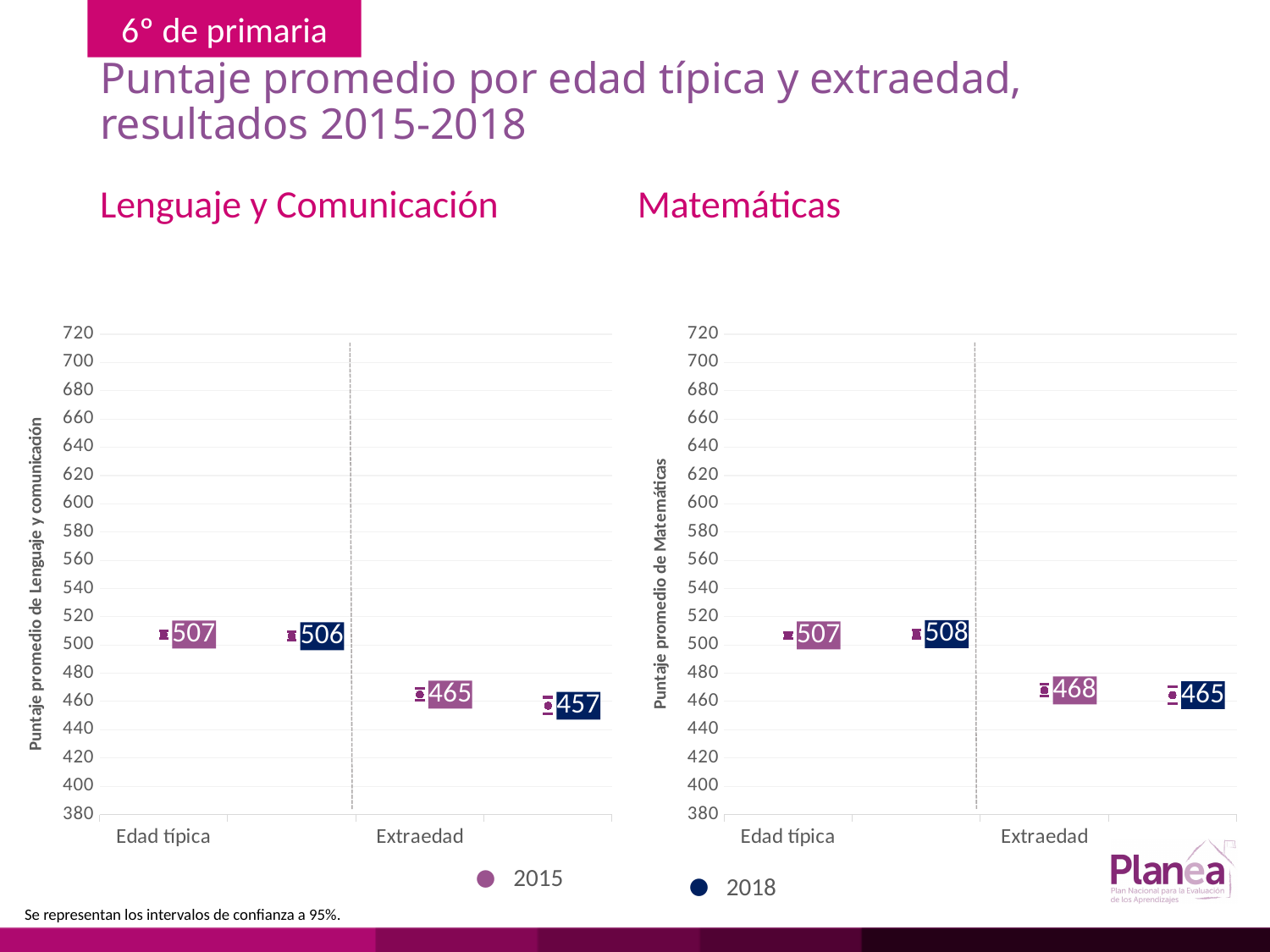
In the Lenguaje y Comunicación chart, what is the 2015 value for Edad típica? 507 How many series does the legend list for the charts? 2 In the Matemáticas chart, which category has the highest 2015 value? Edad típica In the Lenguaje y Comunicación chart, what is the 2018 value for Extraedad? 457 In the Matemáticas chart, is the 2015 value for Extraedad greater or less than 500? less In the Lenguaje y Comunicación chart, which category has the lowest 2018 value? Extraedad In the Matemáticas chart, what is the 2015 value for Extraedad? 468 What is the y-axis title of the Matemáticas chart? Puntaje promedio de Matemáticas In the Matemáticas chart, what is the 2018 value for Edad típica? 508 In the Lenguaje y Comunicación chart, what is the difference between the 2015 and 2018 values for Extraedad? 8 In the Matemáticas chart, what is the difference between the Edad típica and Extraedad values for 2018? 43 How many categories are shown on the x axis of the Lenguaje y Comunicación chart? 2